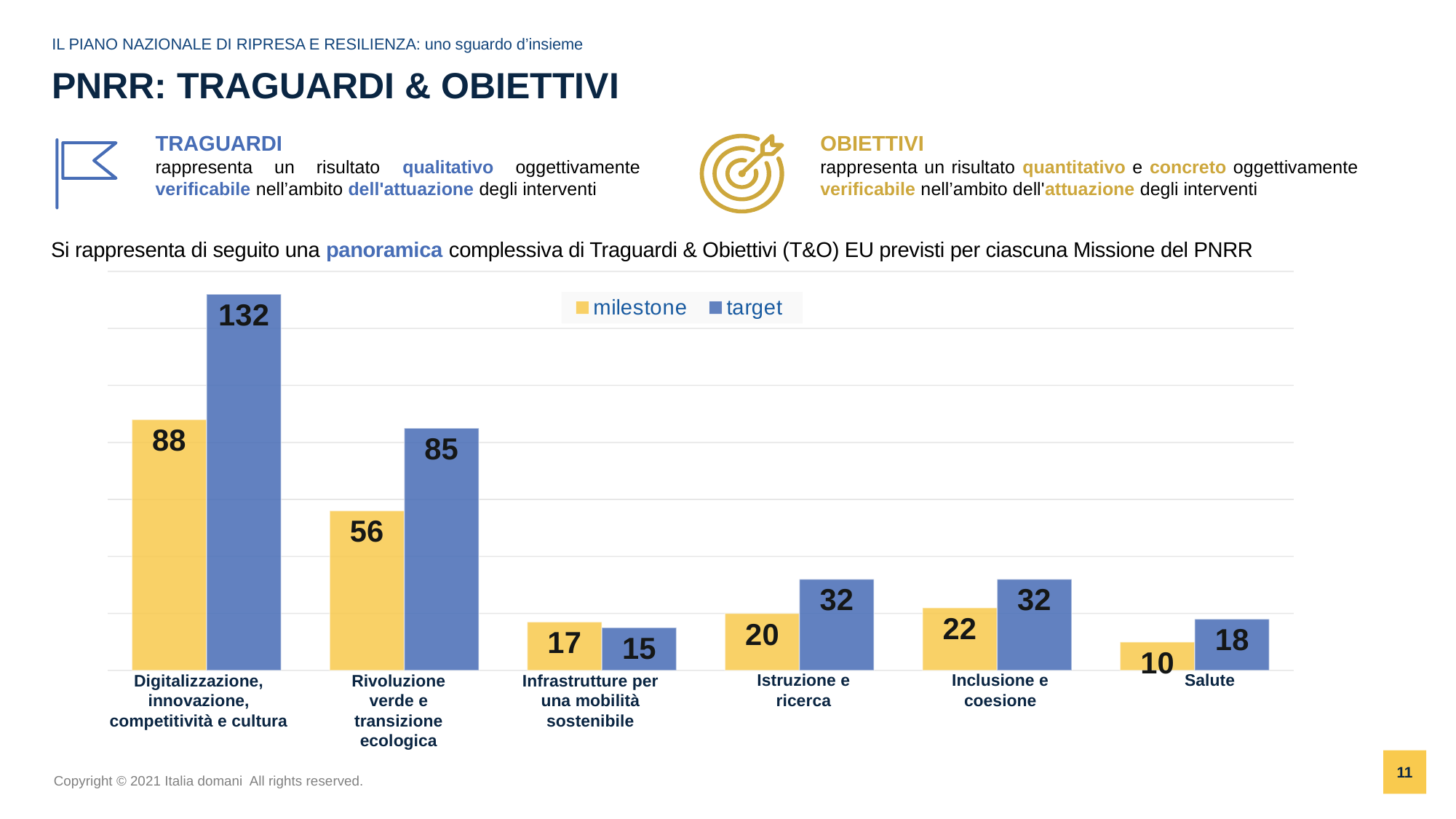
What kind of chart is shown on the slide? bar chart How many categories are shown on the x axis? 6 Which category has the highest target value? Digitalizzazione, innovazione, competitività e cultura For Infrastrutture per una mobilità sostenibile, which is larger: the milestone value or the target value? milestone What is the difference between the target and milestone values for Digitalizzazione, innovazione, competitività e cultura? 44 Which series is shown in yellow in the legend? milestone What is the difference between the milestone values for Inclusione e coesione and Istruzione e ricerca? 2 What is the milestone value for Salute? 10 How many series does the legend list? 2 What is the target value for Rivoluzione verde e transizione ecologica? 85 Which category has the lowest milestone value? Salute What is the milestone value for Digitalizzazione, innovazione, competitività e cultura? 88